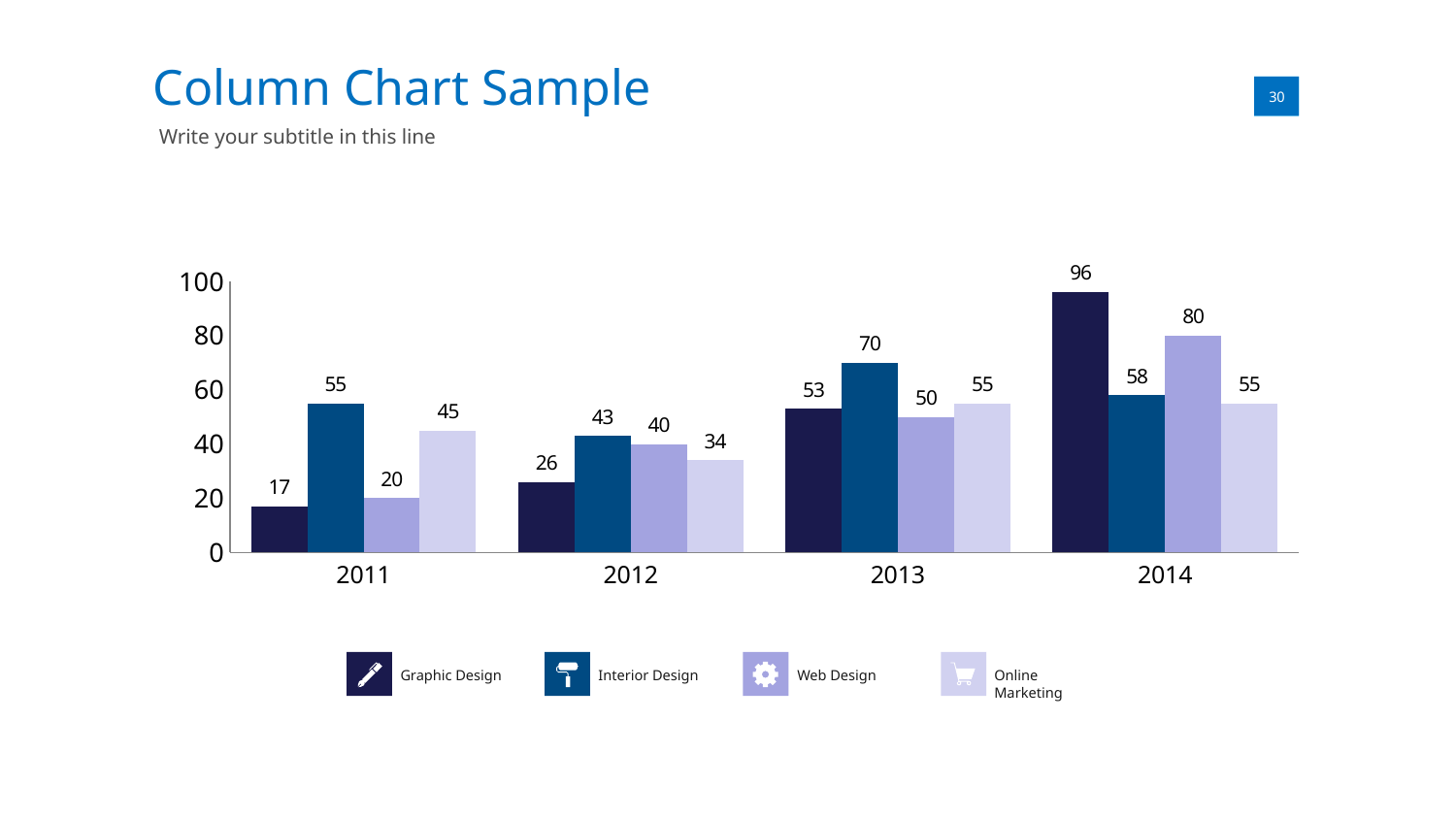
What is the value for Web Design in 2012? 40 What kind of chart is shown on the slide? Bar chart What is the value for Online Marketing in 2011? 45 In which year is the Graphic Design value lowest? 2011 What is the value for Interior Design in 2013? 70 Which is larger in 2012: Interior Design or Online Marketing? Interior Design In which year is the Graphic Design value highest? 2014 What is the difference between the Web Design values for 2014 and 2013? 30 What is the value for Graphic Design in 2014? 96 How many series does the legend list? 4 Does the Graphic Design value rise or fall from 2011 to 2014? Rise How many years are shown on the x axis? 4